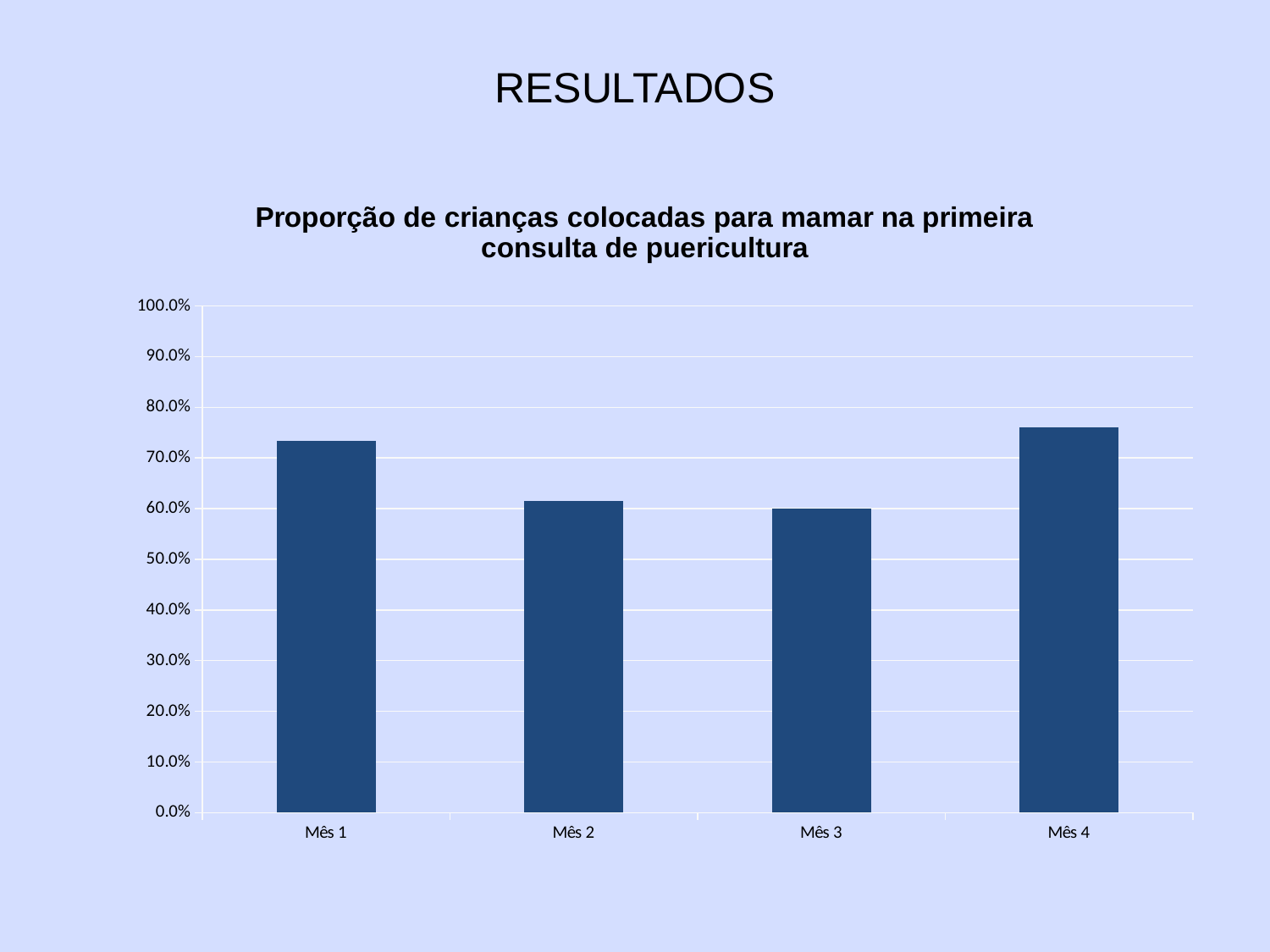
Is the value for Mês 4 greater or less than 80%? less Is the value for Mês 3 greater or less than 50%? greater Does the value rise or fall from Mês 1 to Mês 2? fall What is the title of the chart? Proporção de crianças colocadas para mamar na primeira consulta de puericultura Which is larger, the value for Mês 4 or the value for Mês 3? Mês 4 What kind of chart is shown on the slide? Bar chart What is the maximum value shown on the y axis of the chart? 100.0% Which month has the highest proportion in the chart? Mês 4 Is the value for Mês 1 greater or less than 70%? greater How many categories (months) are shown on the x axis of the chart? 4 Which is larger, the value for Mês 1 or the value for Mês 2? Mês 1